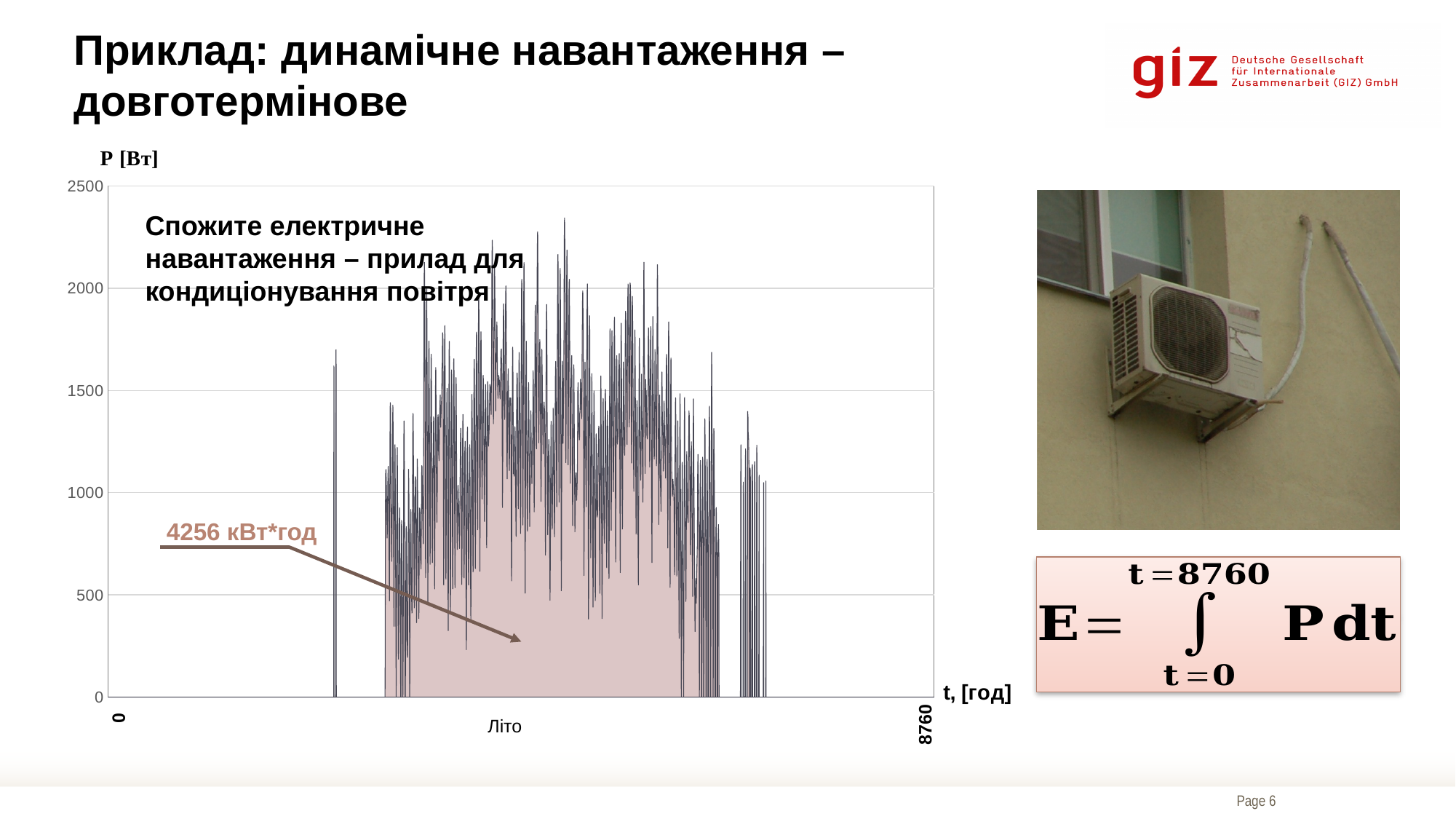
What total energy value is annotated on the chart? 4256 кВт*год Is the peak value of the plotted load greater or less than 2500? less What is the label of the y axis of the chart? P [Вт] What label is written below the x axis in the middle of the chart? Літо What kind of chart is shown on the slide? area chart Is the plotted value at t = 8760 greater or less than 500? less Is the peak value of the plotted load greater or less than 2000? greater What is the highest tick value shown on the y axis of the chart? 2500 What is the last tick value shown on the x axis of the chart? 8760